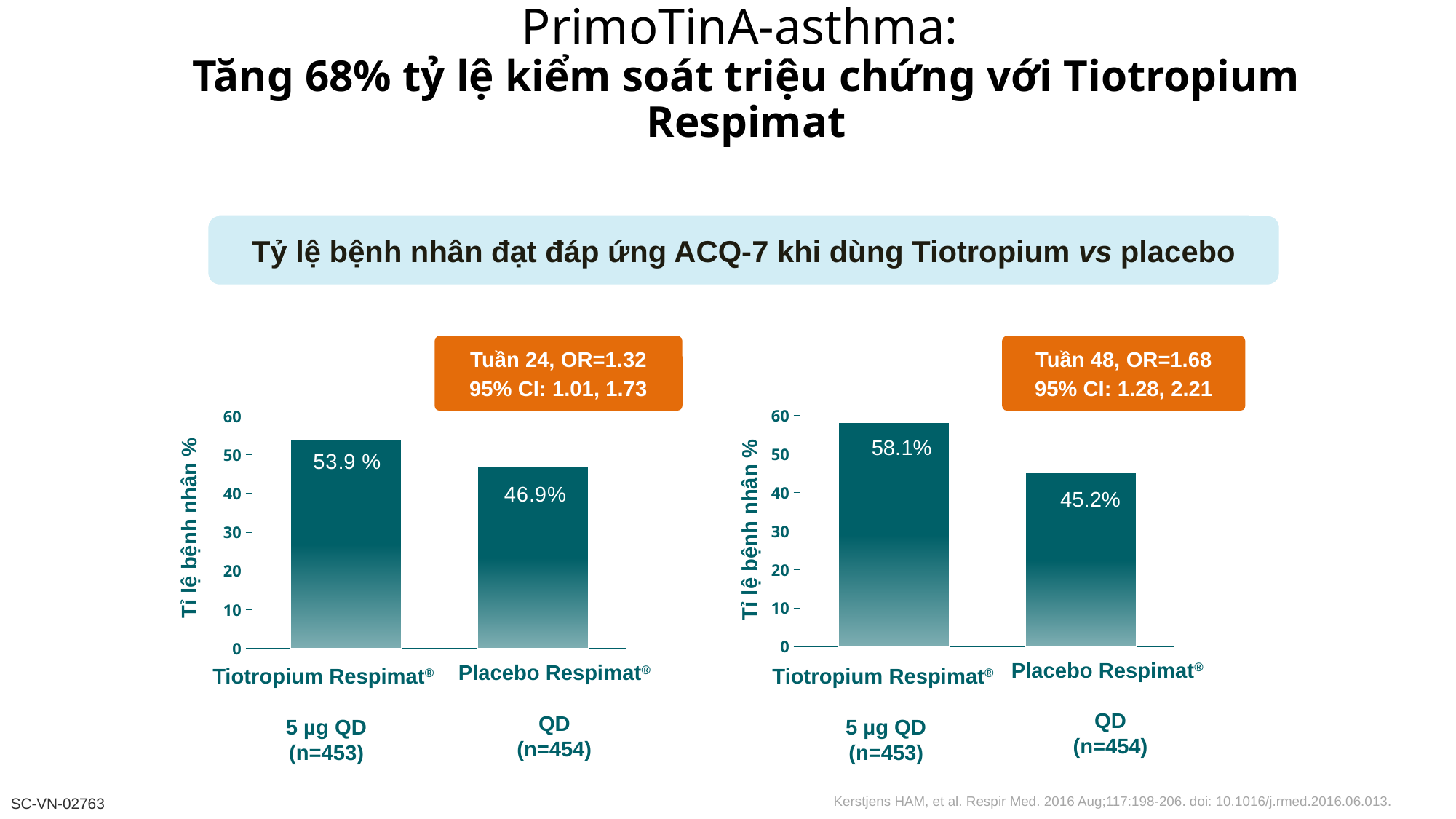
In the left chart (Tuần 24), what is the value for Placebo Respimat? 46.9% In the left chart (Tuần 24), what is the difference between the Tiotropium Respimat and Placebo Respimat values? 7.0 percentage points In the left chart (Tuần 24), which category has the lowest value? Placebo Respimat In the right chart (Tuần 48), what is the difference between the Tiotropium Respimat and Placebo Respimat values? 12.9 percentage points What is the y-axis label of the right chart (Tuần 48)? Tỉ lệ bệnh nhân % What kind of chart is the left chart (Tuần 24)? Bar chart In the right chart (Tuần 48), what is the value for Placebo Respimat? 45.2% In the left chart (Tuần 24), is the value for Tiotropium Respimat greater or less than 50? greater In the right chart (Tuần 48), what is the value for Tiotropium Respimat? 58.1% In the right chart (Tuần 48), which category has the highest value? Tiotropium Respimat How many bars are plotted in the right chart (Tuần 48)? 2 In the left chart (Tuần 24), what is the value for Tiotropium Respimat? 53.9 %